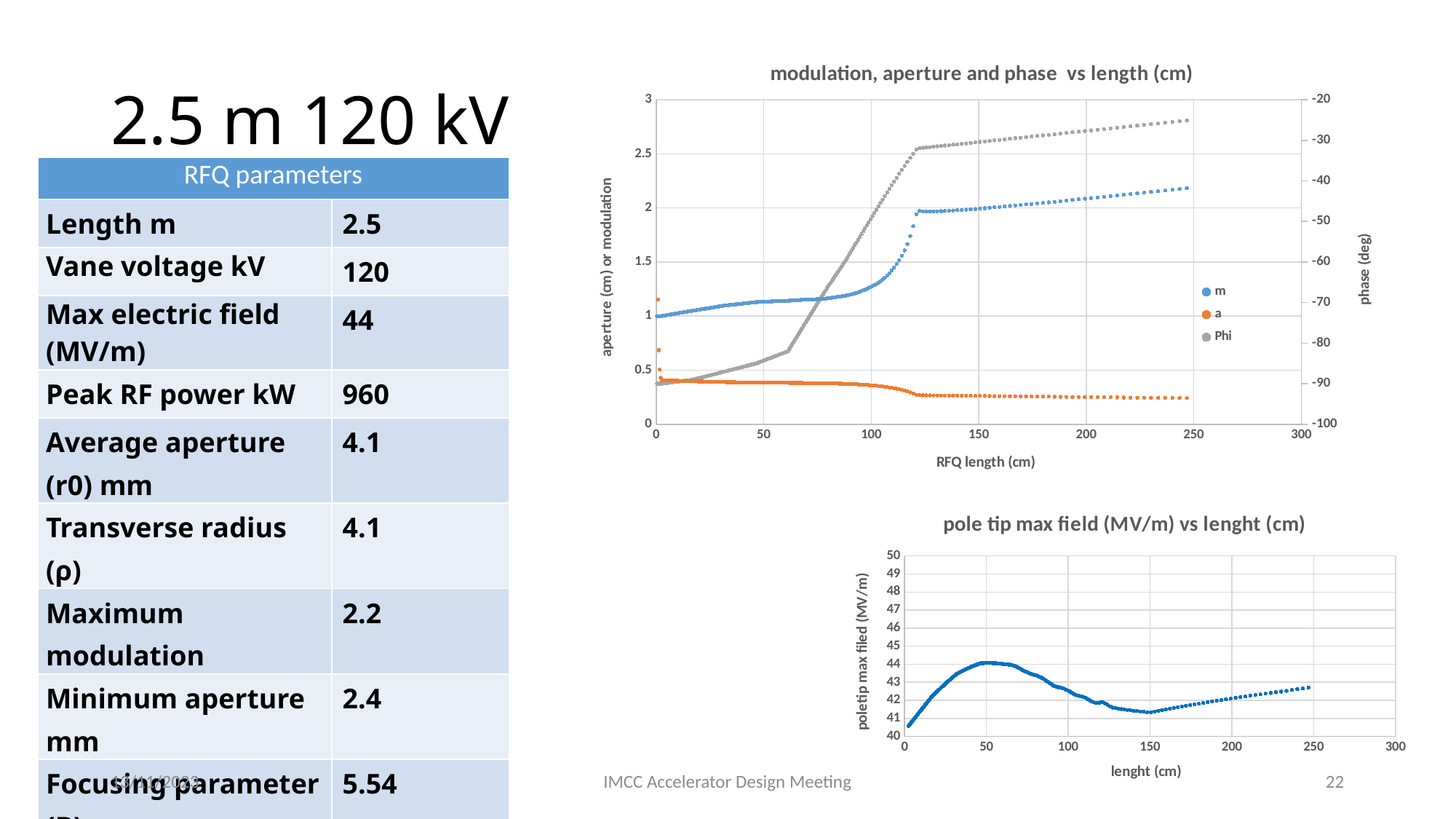
In the bottom chart 'pole tip max field (MV/m) vs lenght (cm)', is the value at 150 cm greater or less than 42? less In the top chart 'modulation, aperture and phase vs length (cm)', what are the three legend entries? m, a, Phi In the top chart 'modulation, aperture and phase vs length (cm)', is the value of series a at 200 cm greater or less than 0.5? less In the top chart 'modulation, aperture and phase vs length (cm)', is the value of series m at 50 cm greater or less than 1.5? less What kind of chart is the top chart titled 'modulation, aperture and phase vs length (cm)'? scatter chart In the top chart 'modulation, aperture and phase vs length (cm)', what is the title of the right-hand vertical axis? phase (deg) In the top chart 'modulation, aperture and phase vs length (cm)', does series a rise or fall as RFQ length increases? fall What kind of chart is the bottom chart titled 'pole tip max field (MV/m) vs lenght (cm)'? scatter chart How many series does the legend of the top chart 'modulation, aperture and phase vs length (cm)' list? 3 In the top chart 'modulation, aperture and phase vs length (cm)', does series m rise or fall as RFQ length increases? rise In the bottom chart 'pole tip max field (MV/m) vs lenght (cm)', does the value rise or fall between 50 cm and 150 cm? fall